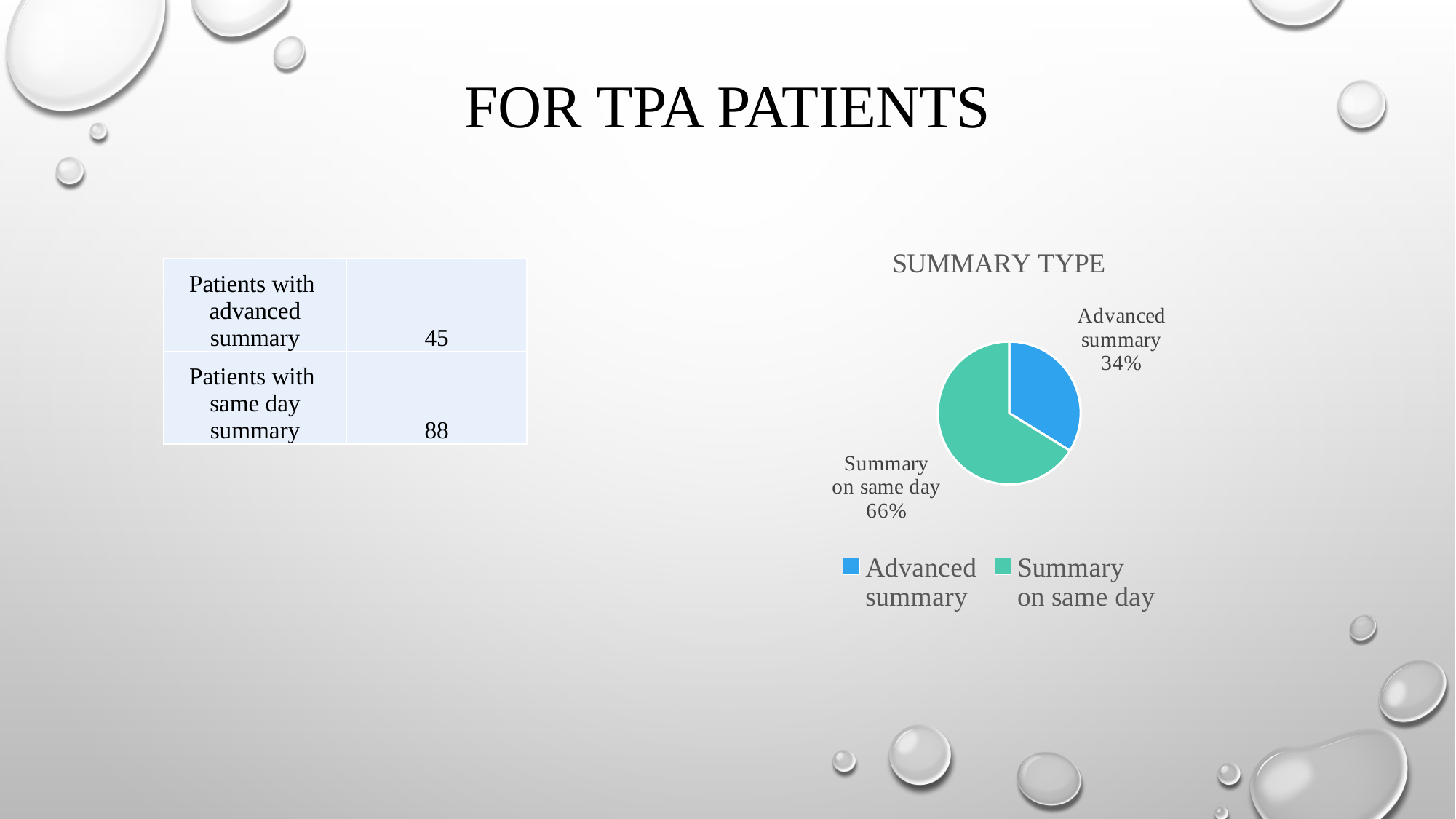
Which slice of the pie is the largest? Summary on same day How many slices does the pie chart have? 2 How many entries does the legend list? 2 What kind of chart is shown on the slide? pie chart What colour is the Advanced summary slice? blue Is the share for Summary on same day greater or less than 50%? greater Which is larger, the share for Advanced summary or the share for Summary on same day? Summary on same day What share of the pie does Summary on same day represent? 66% What share of the pie does Advanced summary represent? 34% What is the difference in percentage points between the Summary on same day share and the Advanced summary share? 32 What is the title of the chart? SUMMARY TYPE Which slice of the pie is the smallest? Advanced summary